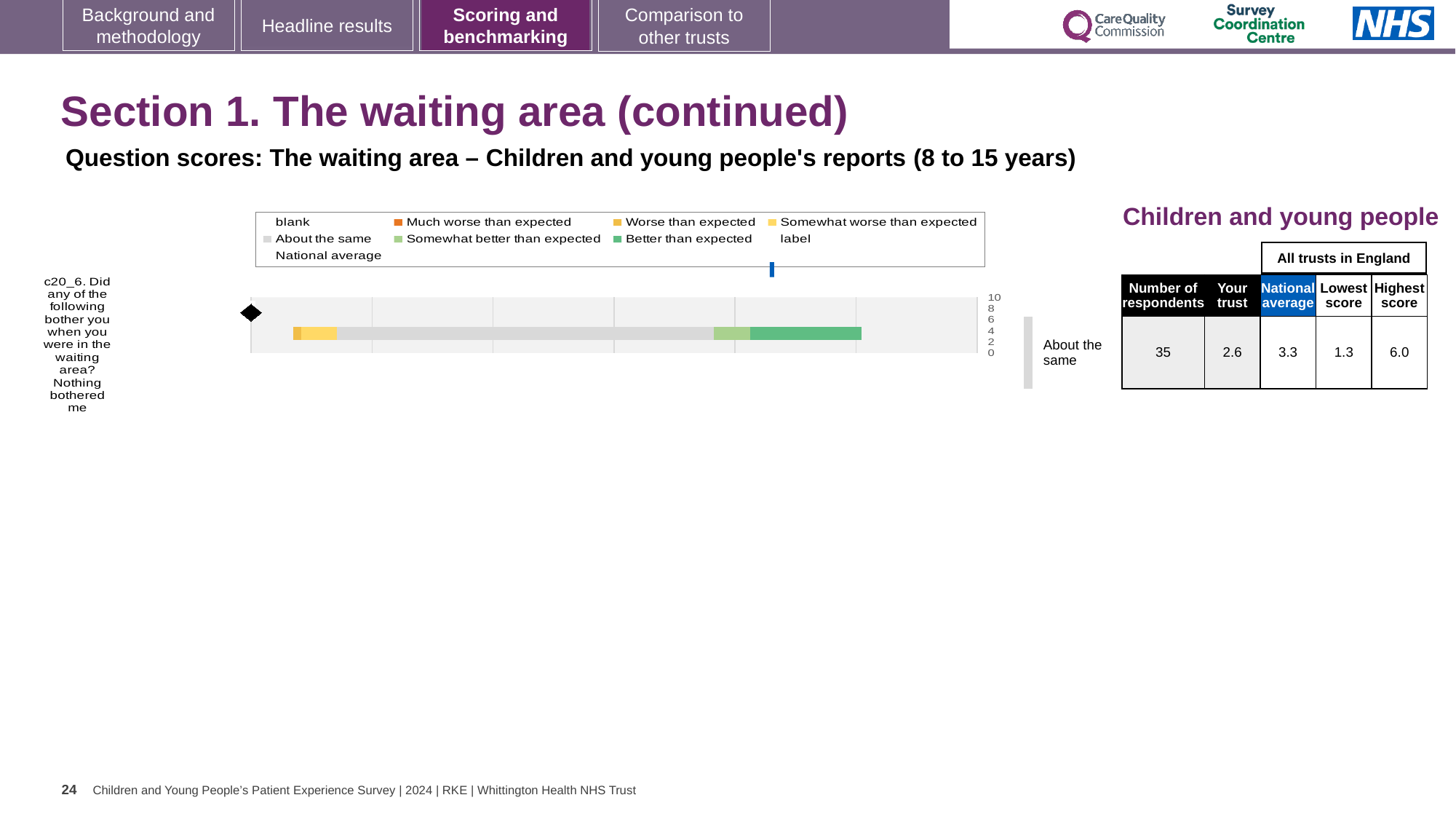
In the table, how many respondents answered question c20_6? 35 Which is larger for question c20_6: the 'Your trust' score or the National average? National average How many question categories are plotted in the chart? 1 What kind of chart is shown on the slide? bar chart In the table, what is the Lowest score across all trusts in England for question c20_6? 1.3 In the table, what is the Highest score across all trusts in England for question c20_6? 6.0 What is the difference between the Highest score and the Lowest score for question c20_6? 4.7 In the table, what is the National average score for question c20_6? 3.3 What benchmark label is shown to the right of the bar for question c20_6? About the same In the table, what is the 'Your trust' score for question c20_6? 2.6 Which question is plotted in the chart? c20_6. Did any of the following bother you when you were in the waiting area? Nothing bothered me How many entries does the chart legend list? 9